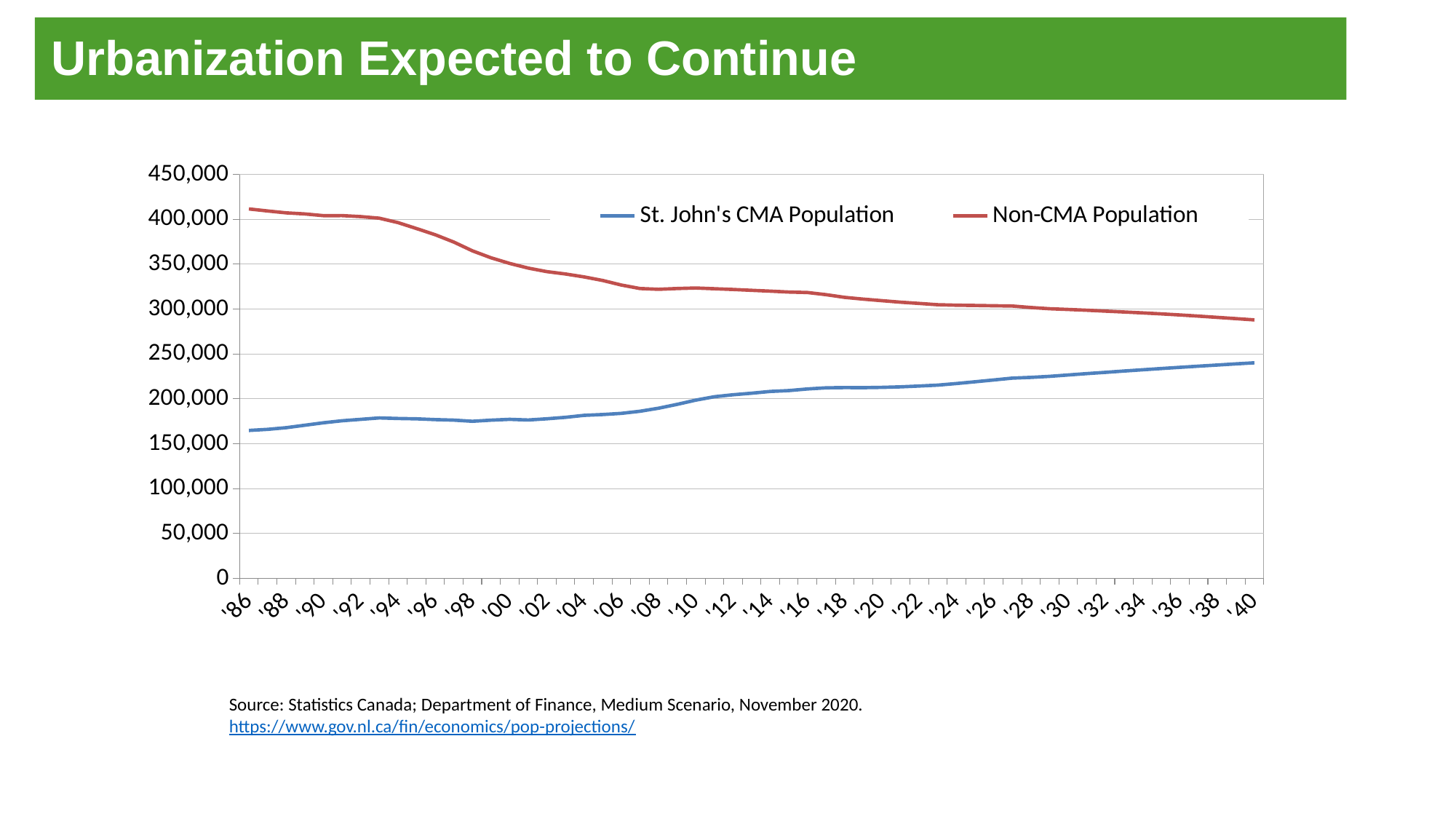
Is the Non-CMA Population value for '86 greater or less than 400,000? greater Does the Non-CMA Population line rise or fall from '86 to '40? fall In which year does the Non-CMA Population line reach its highest value? '86 Is the St. John's CMA Population value for '40 greater or less than 200,000? greater Is the St. John's CMA Population value for '86 greater or less than 200,000? less What kind of chart is shown on the slide? line chart Does the St. John's CMA Population line rise or fall from '86 to '40? rise Which series has the higher value in '40, St. John's CMA Population or Non-CMA Population? Non-CMA Population How many series does the legend list? 2 What is the title of the slide containing the chart? Urbanization Expected to Continue Which series is shown in red? Non-CMA Population